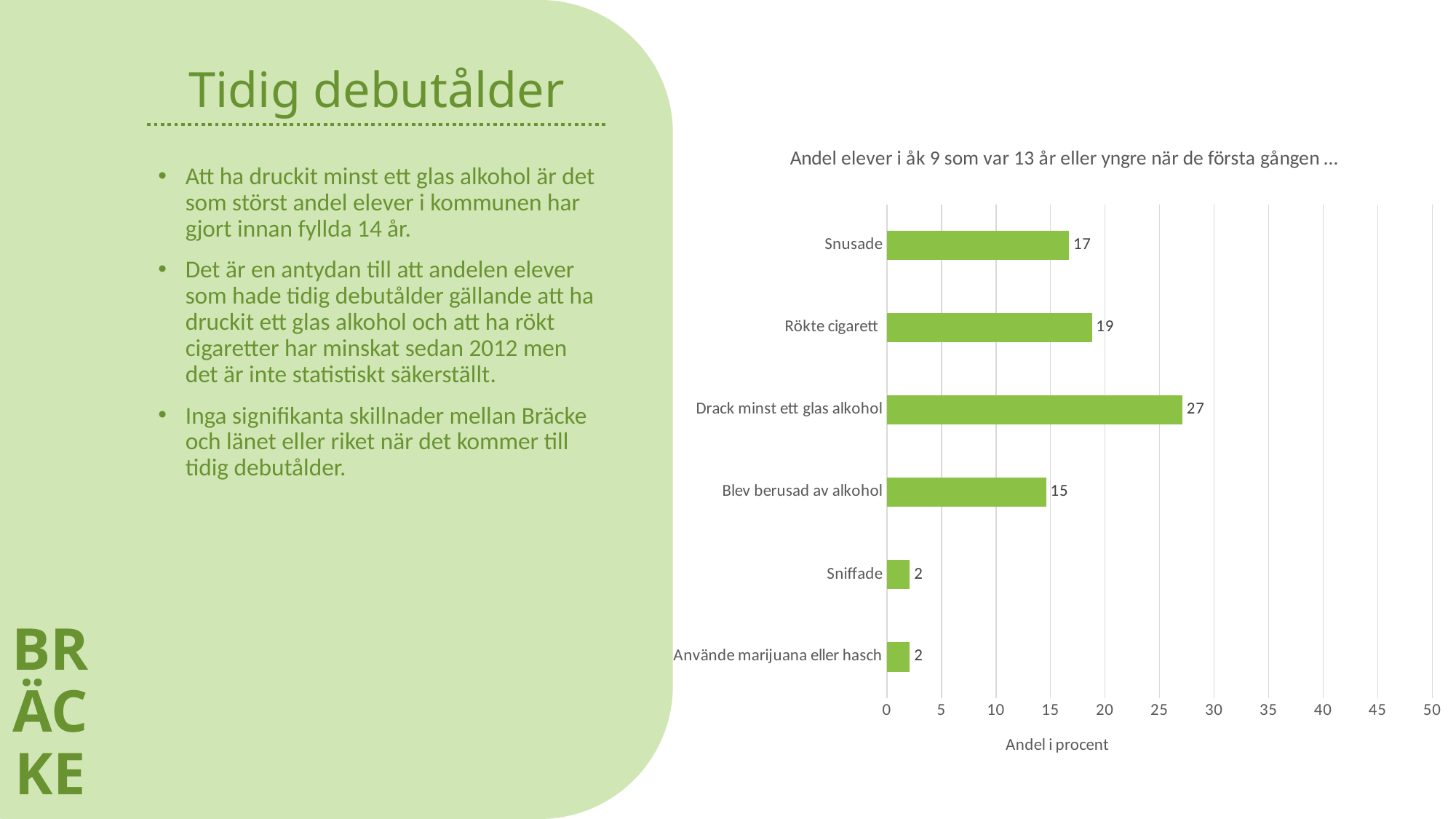
Which is larger, the value for Rökte cigarett or the value for Snusade? Rökte cigarett How many categories are shown in the chart? 6 Which category has the highest value? Drack minst ett glas alkohol What is the label of the horizontal axis? Andel i procent What is the highest tick value shown on the horizontal axis? 50 What is the value for Snusade? 17 What is the difference between the values for Drack minst ett glas alkohol and Blev berusad av alkohol? 12 Is the value for Drack minst ett glas alkohol greater or less than 25? greater What is the value for Sniffade? 2 What kind of chart is shown on the slide? bar chart What is the value for Rökte cigarett? 19 What is the value for Blev berusad av alkohol? 15